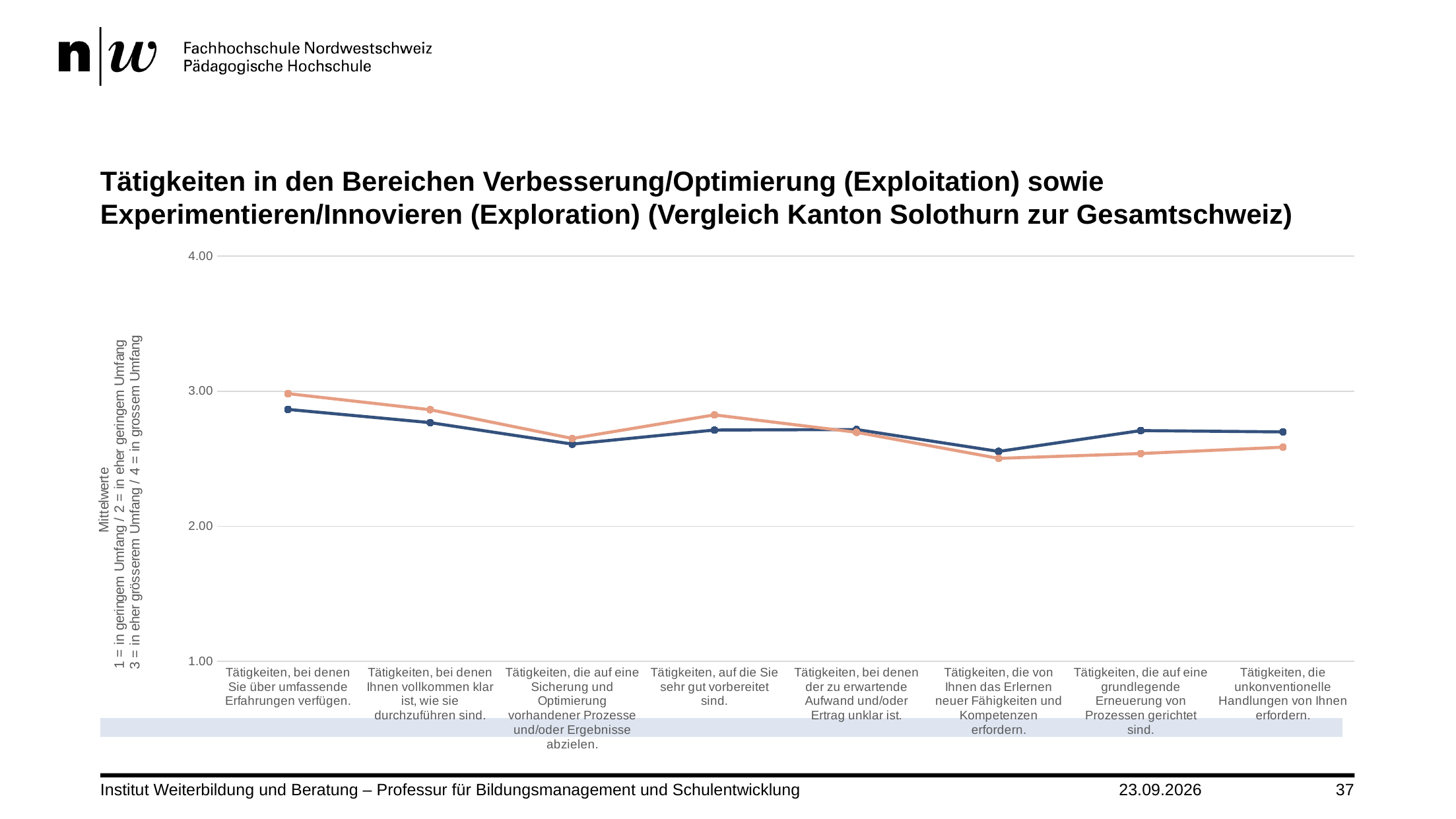
How many lines are plotted in the chart? 2 Is the value of the blue line for "Tätigkeiten, die unkonventionelle Handlungen von Ihnen erfordern." greater or less than 3.00? less How many categories are shown along the x axis of the chart? 8 What kind of chart is shown on the slide? line chart For which category does the orange line reach its highest value? Tätigkeiten, bei denen Sie über umfassende Erfahrungen verfügen. Is the value of the blue line for "Tätigkeiten, bei denen Sie über umfassende Erfahrungen verfügen." greater or less than 2.00? greater For which category does the blue line reach its highest value? Tätigkeiten, bei denen Sie über umfassende Erfahrungen verfügen. Does the orange line rise or fall from the first category to the second category? fall For "Tätigkeiten, die auf eine grundlegende Erneuerung von Prozessen gerichtet sind.", which line has the higher value, the blue or the orange one? blue Is the value of the orange line for "Tätigkeiten, die von Ihnen das Erlernen neuer Fähigkeiten und Kompetenzen erfordern." greater or less than 3.00? less For "Tätigkeiten, bei denen Sie über umfassende Erfahrungen verfügen.", which line has the higher value, the blue or the orange one? orange What is the highest value shown on the y axis of the chart? 4.00